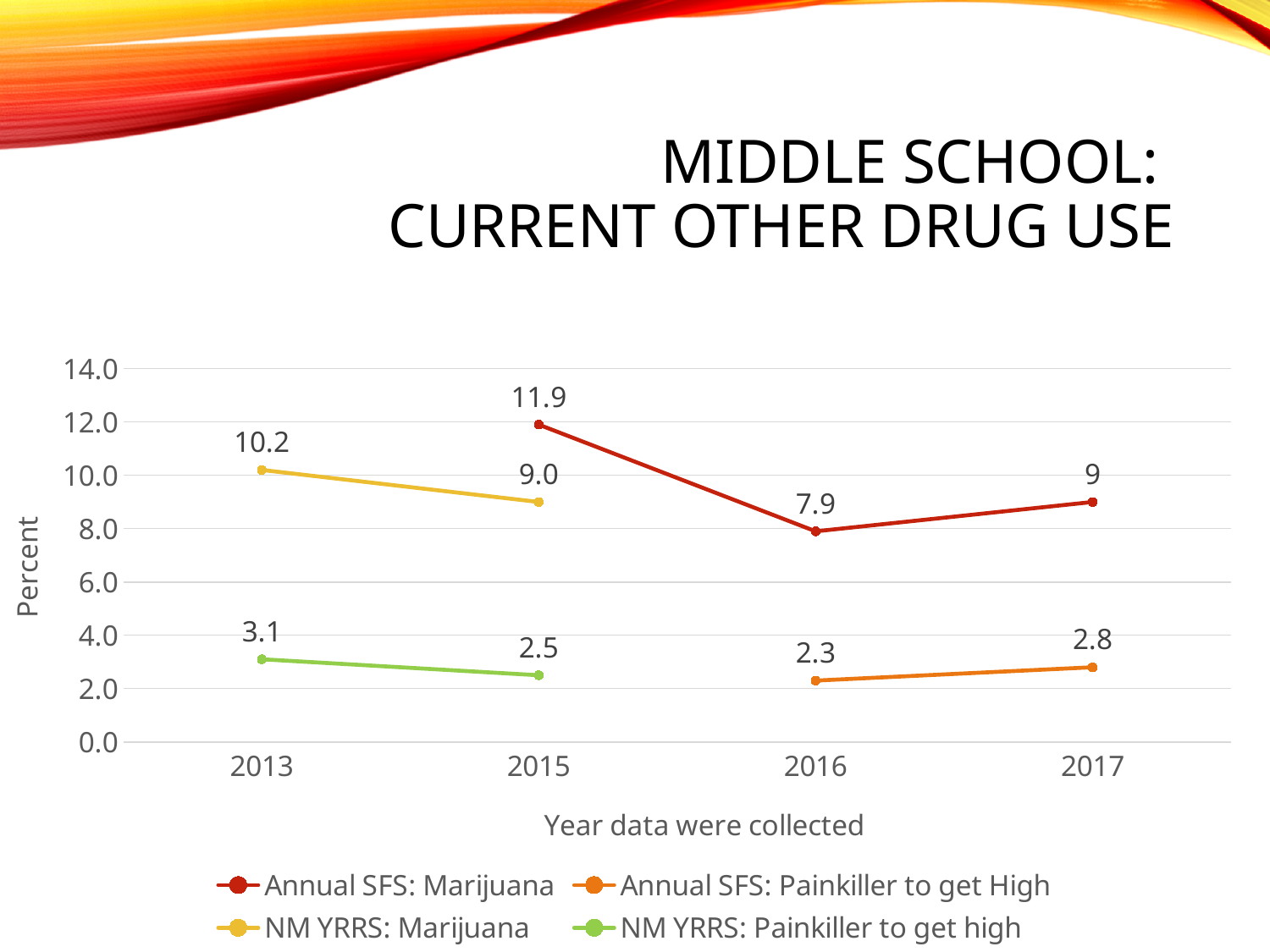
What is the value for Annual SFS: Painkiller to get High in 2017? 2.8 In which year does the Annual SFS: Marijuana series reach its lowest value? 2016 What is the value for NM YRRS: Marijuana in 2013? 10.2 What is the highest value plotted on the chart? 11.9 What is the value for Annual SFS: Marijuana in 2015? 11.9 What is the difference between the Annual SFS: Marijuana values for 2015 and 2016? 4.0 How many series does the legend list? 4 What is the value for NM YRRS: Painkiller to get high in 2015? 2.5 Which is larger: NM YRRS: Marijuana in 2013 or Annual SFS: Marijuana in 2017? NM YRRS: Marijuana in 2013 What kind of chart is shown on the slide? line chart Does the NM YRRS: Marijuana series rise or fall from 2013 to 2015? fall How many years are shown on the x axis? 4